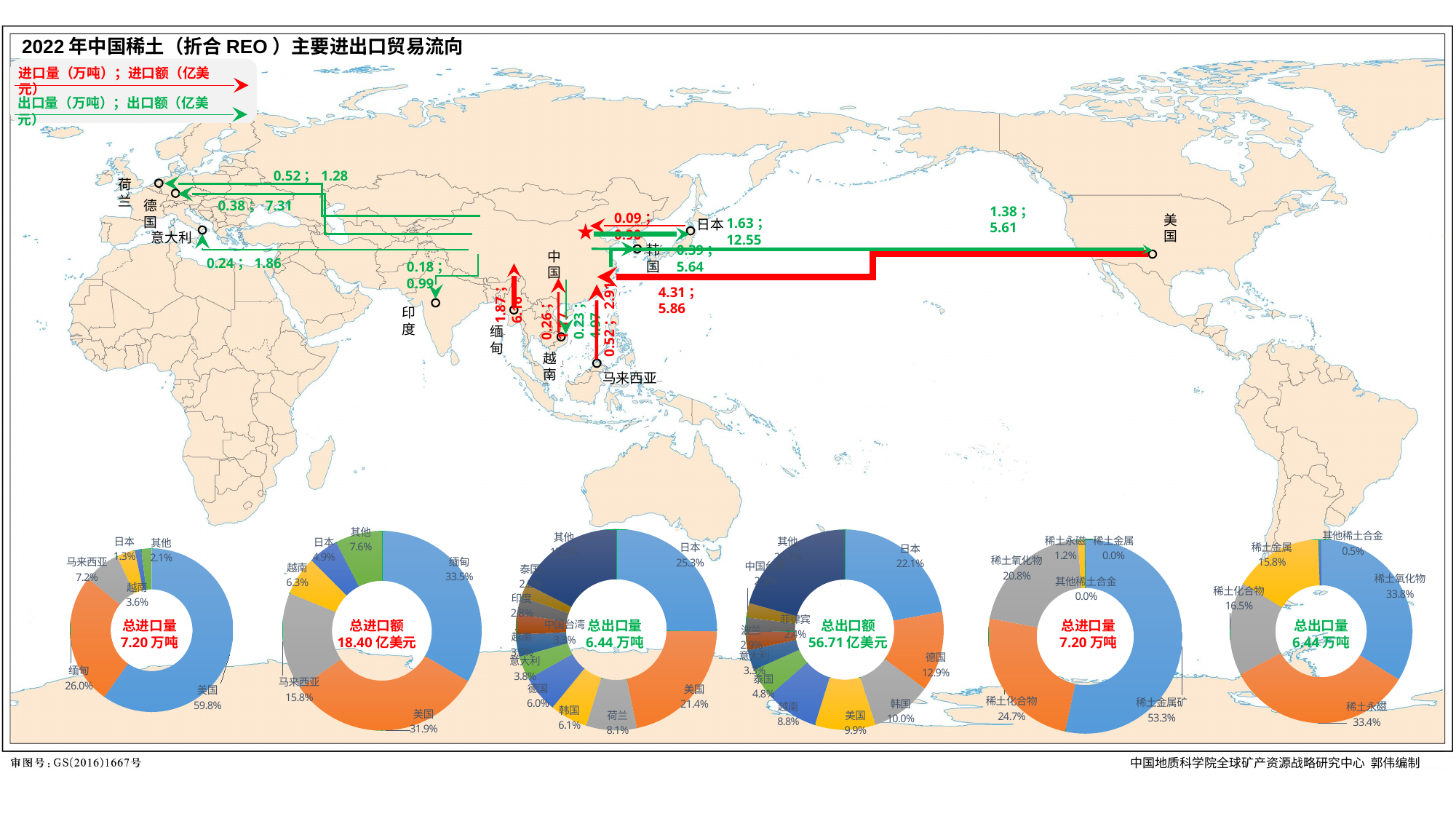
In the fourth donut chart from the left (总出口额 56.71 亿美元), what share does 德国 hold? 12.9% In the leftmost donut chart (总进口量 7.20 万吨, by country), what share does 美国 hold? 59.8% In the leftmost donut chart (总进口量 7.20 万吨, by country), which country has the largest share? 美国 In the fifth donut chart from the left (总进口量 7.20 万吨, by product), which product has the largest share? 稀土金属矿 In the fifth donut chart from the left (总进口量 7.20 万吨, by product), what share does 稀土化合物 hold? 24.7% In the rightmost donut chart (总出口量 6.44 万吨, by product), which product has the smallest share? 其他稀土合金 What kind of charts are shown along the bottom of the slide? Donut (pie) charts In the third donut chart from the left (总出口量 6.44 万吨, by country), what is the difference between the shares of 日本 and 美国? 3.9% In the second donut chart from the left (总进口额 18.40 亿美元), which is larger, the share of 缅甸 or the share of 美国? 缅甸